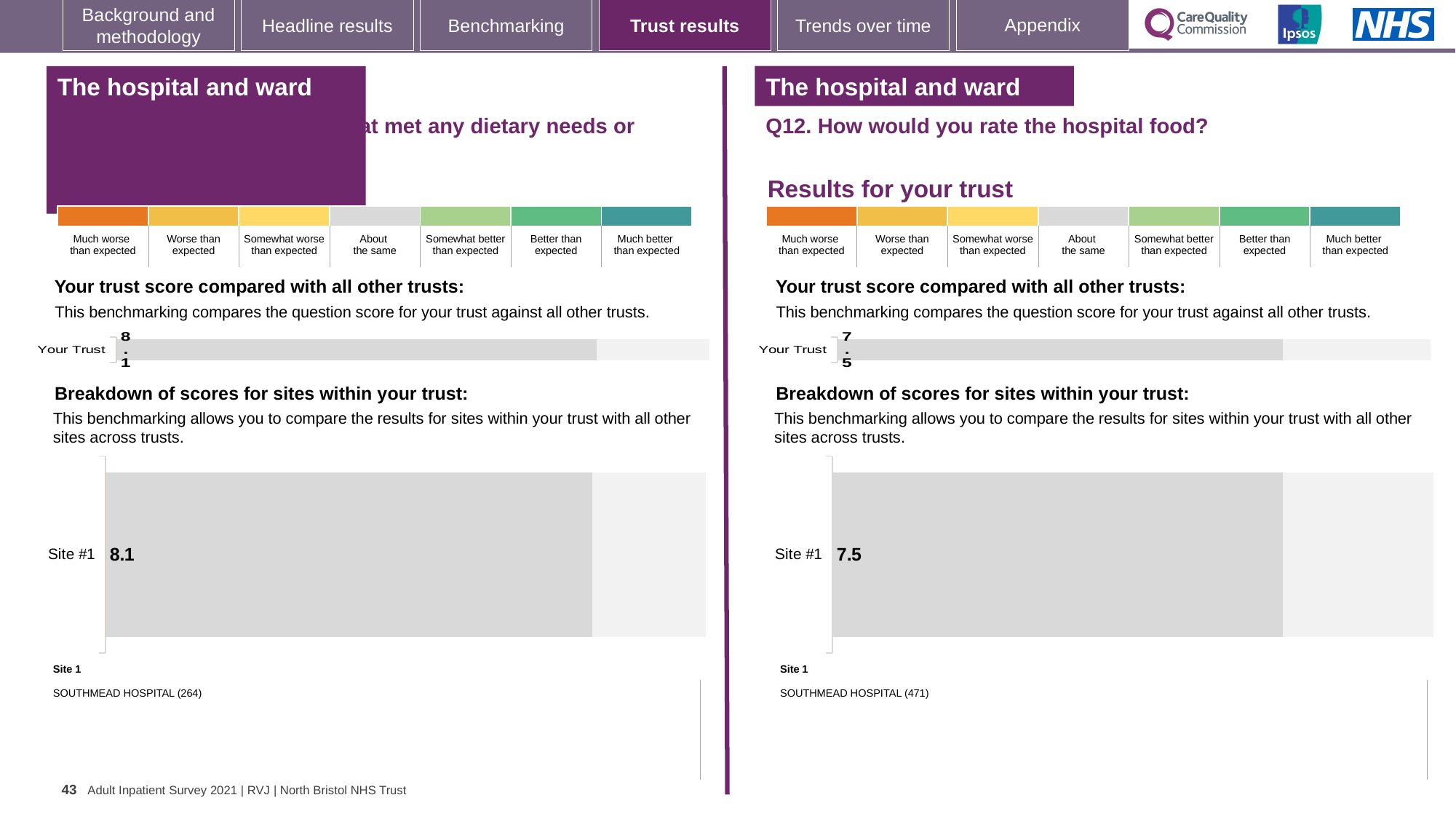
How many sites are shown in the 'Breakdown of scores for sites within your trust' chart on the right-hand side? 1 Which is larger: the Site #1 score on the left-hand chart or the Site #1 score on the right-hand Q12 chart? Left-hand chart (8.1) On the right-hand 'Your trust score compared with all other trusts' chart for Q12, what is the value for Your Trust? 7.5 On the left-hand 'Your trust score compared with all other trusts' chart, what is the value for Your Trust? 8.1 What type of chart is used to show the breakdown of scores for sites within your trust on the left-hand side? Bar chart What is the difference between the Site #1 score on the left-hand chart and the Site #1 score on the right-hand Q12 chart? 0.6 On the left-hand chart, which hospital is listed as Site 1? SOUTHMEAD HOSPITAL (264) On the right-hand Q12 chart, which hospital is listed as Site 1? SOUTHMEAD HOSPITAL (471) How many sites are shown in the 'Breakdown of scores for sites within your trust' chart on the left-hand side? 1 On the left-hand chart, what is the score shown for Site #1? 8.1 On the right-hand chart for Q12 (How would you rate the hospital food?), what is the score shown for Site #1? 7.5